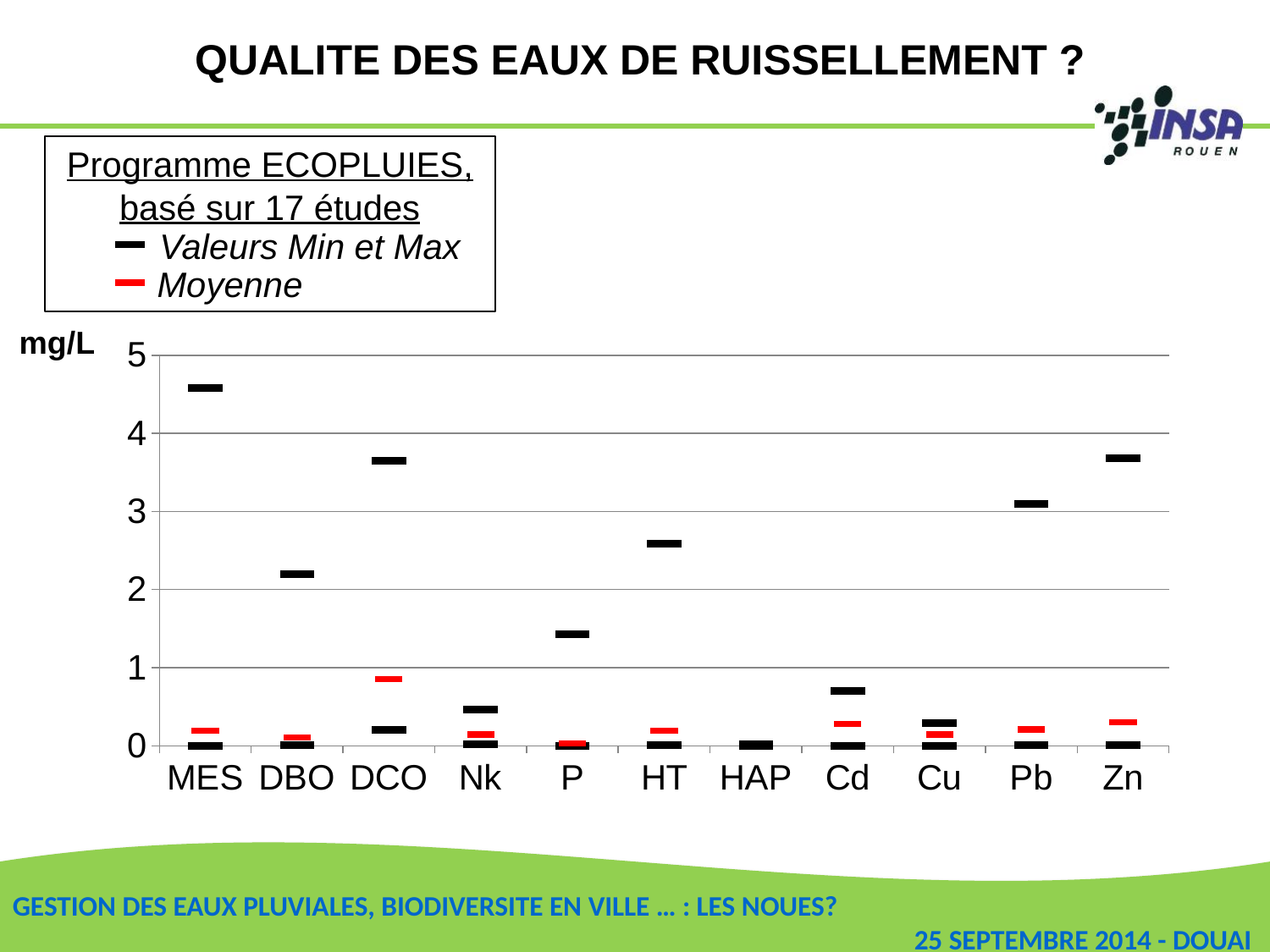
Which category has the highest maximum value (black marker) on the chart? MES According to the legend, what do the red markers represent? Moyenne How many entries does the chart's legend list? 2 Which has the larger maximum value, DCO or HT? DCO Is the maximum value for MES greater or less than 4 mg/L? greater Is the maximum value for HT greater or less than 3 mg/L? less Which category has the lowest maximum value (black marker) on the chart? HAP Which category has the highest mean value (red marker) on the chart? DCO How many categories (parameters) are shown on the x axis of the chart? 11 Is the maximum value for Zn greater or less than 3 mg/L? greater What unit is shown for the y axis of the chart? mg/L